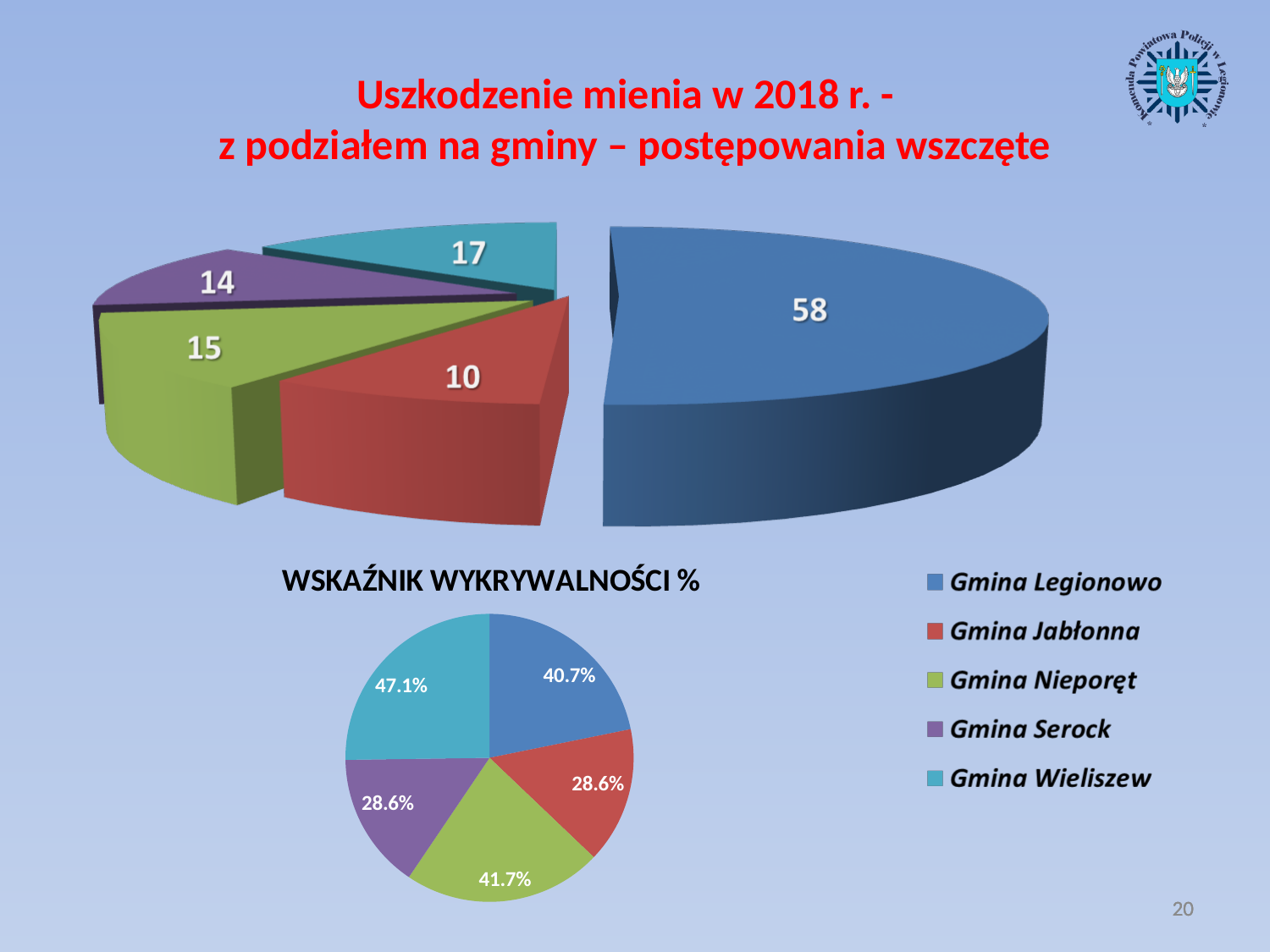
In the top pie chart, what is the sum of all the slice values? 114 What kind of chart is the chart titled WSKAŹNIK WYKRYWALNOŚCI %? pie chart How many slices does the top pie chart have? 5 In the top pie chart, what is the difference between the values for Gmina Legionowo and Gmina Jabłonna? 48 How many entries does the legend on the slide list? 5 In the chart titled WSKAŹNIK WYKRYWALNOŚCI %, what is the value for Gmina Wieliszew? 47.1% In the chart titled WSKAŹNIK WYKRYWALNOŚCI %, which gmina has the highest value? Gmina Wieliszew In the top pie chart, what is the value for Gmina Wieliszew? 17 In the chart titled WSKAŹNIK WYKRYWALNOŚCI %, what is the value for Gmina Nieporęt? 41.7% In the top pie chart, which gmina has the highest value? Gmina Legionowo In the top pie chart, which gmina has the lowest value? Gmina Jabłonna In the top pie chart, what is the value for Gmina Legionowo? 58